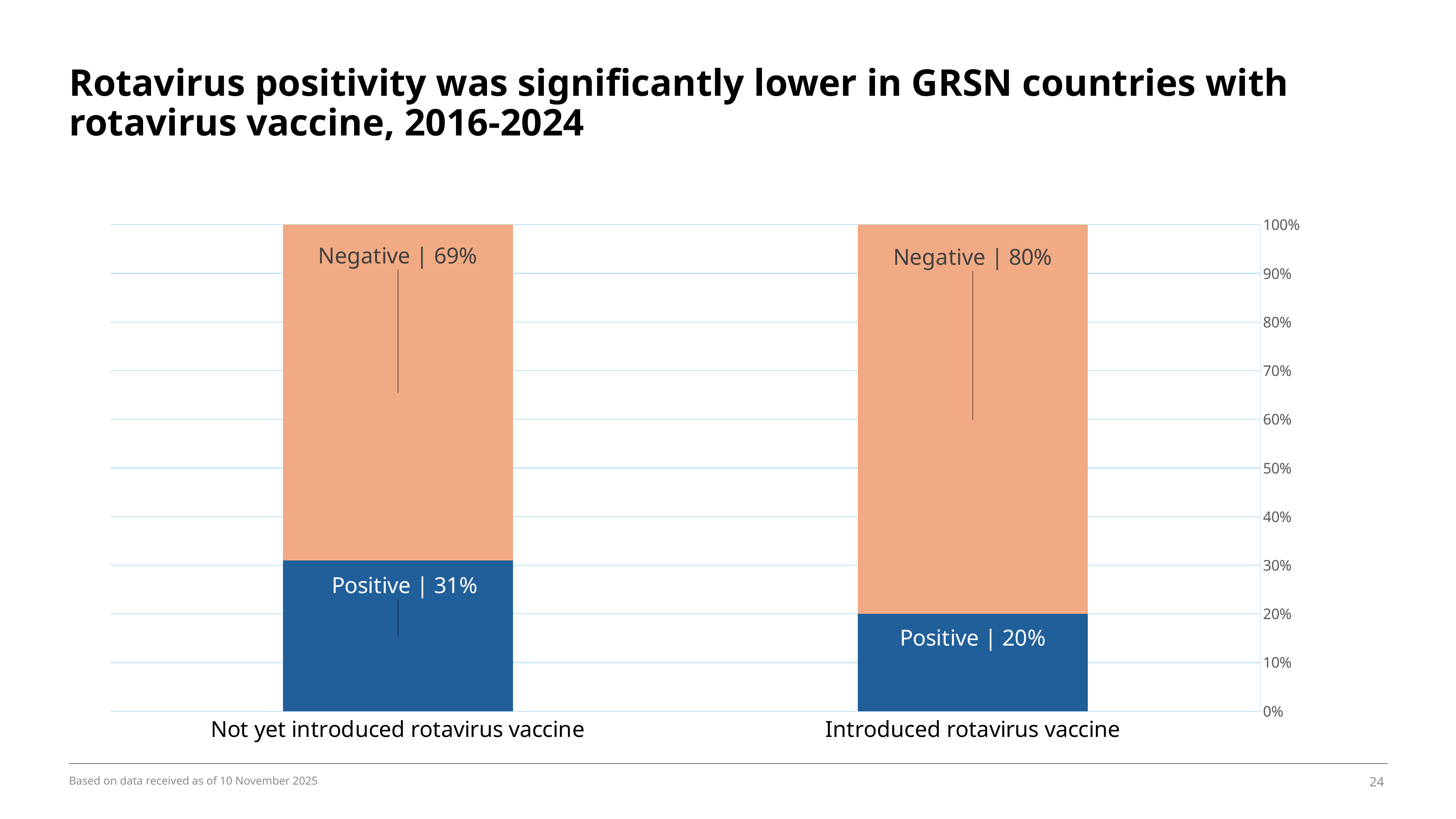
Is the Negative value for Introduced rotavirus vaccine larger or smaller than the Negative value for Not yet introduced rotavirus vaccine? larger Which category has the higher Positive value? Not yet introduced rotavirus vaccine Which category has the lower Negative value? Not yet introduced rotavirus vaccine What is the Negative value for Not yet introduced rotavirus vaccine? 69% What is the difference between the Positive values for Not yet introduced rotavirus vaccine and Introduced rotavirus vaccine? 11% What is the total of the stacked bar for Not yet introduced rotavirus vaccine? 100% What is the Positive value for Introduced rotavirus vaccine? 20% What is the Positive value for Not yet introduced rotavirus vaccine? 31% What kind of chart is shown on the slide? stacked bar chart How many categories are shown on the x axis? 2 What is the Negative value for Introduced rotavirus vaccine? 80% What colour are the Positive segments of the bars? blue